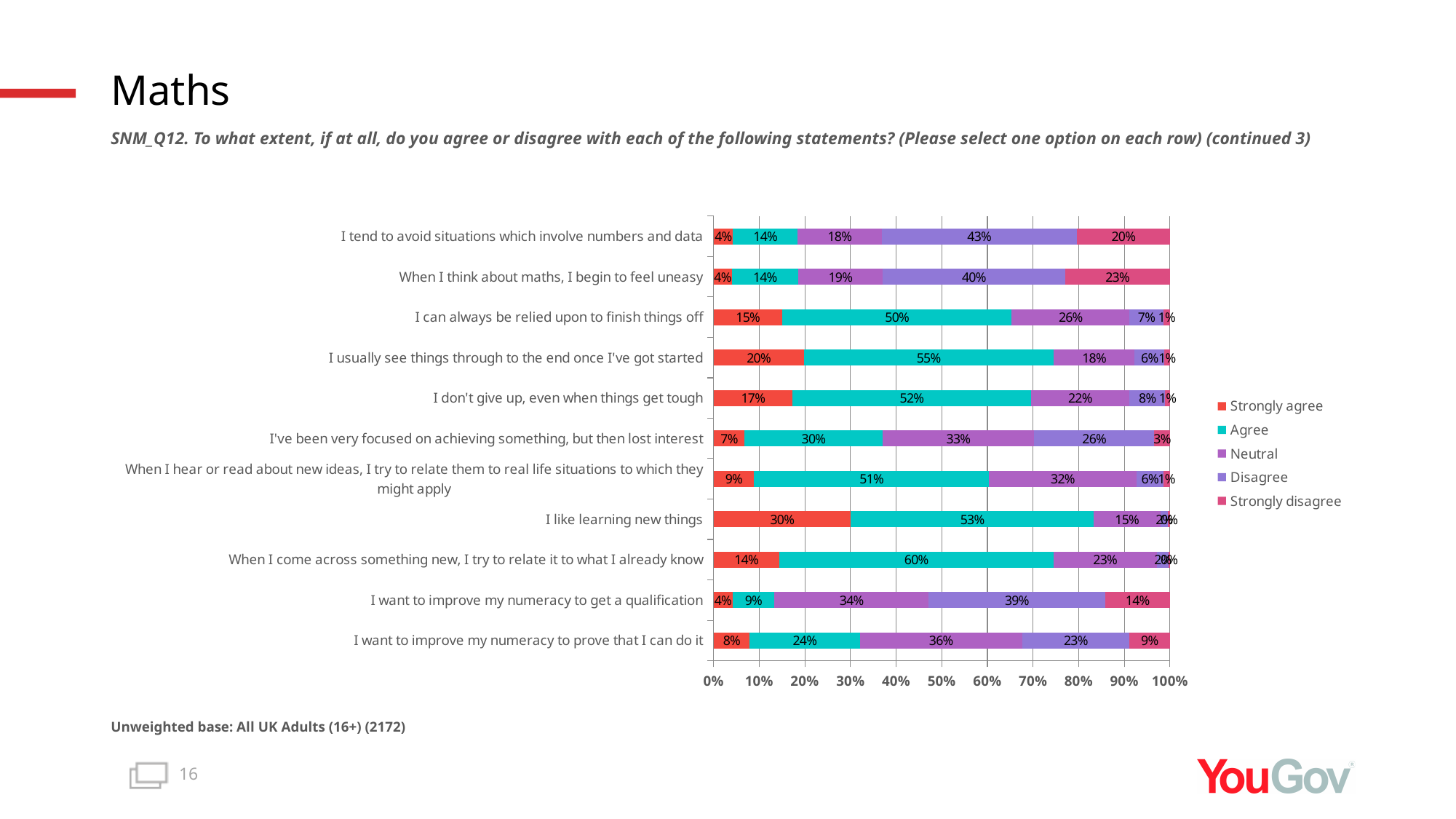
Which legend entry is shown in red? Strongly agree What kind of chart is shown on the slide? Stacked bar chart What percentage of respondents 'Agree' with the statement 'When I come across something new, I try to relate it to what I already know'? 60% How many statements are shown on the chart? 11 What is the 'Disagree' value for 'I want to improve my numeracy to get a qualification'? 39% Which is larger: the 'Neutral' value for 'I want to improve my numeracy to prove that I can do it' or the 'Neutral' value for 'I've been very focused on achieving something, but then lost interest'? I want to improve my numeracy to prove that I can do it Which statement has the highest 'Disagree' value? I tend to avoid situations which involve numbers and data What is the combined 'Strongly agree' and 'Agree' total for 'I can always be relied upon to finish things off'? 65% Which statement has the highest 'Strongly agree' value? I like learning new things What is the 'Strongly disagree' value for 'When I think about maths, I begin to feel uneasy'? 23% What is the difference between the 'Agree' values for 'I usually see things through to the end once I've got started' and 'I don't give up, even when things get tough'? 3% How many series does the legend list? 5